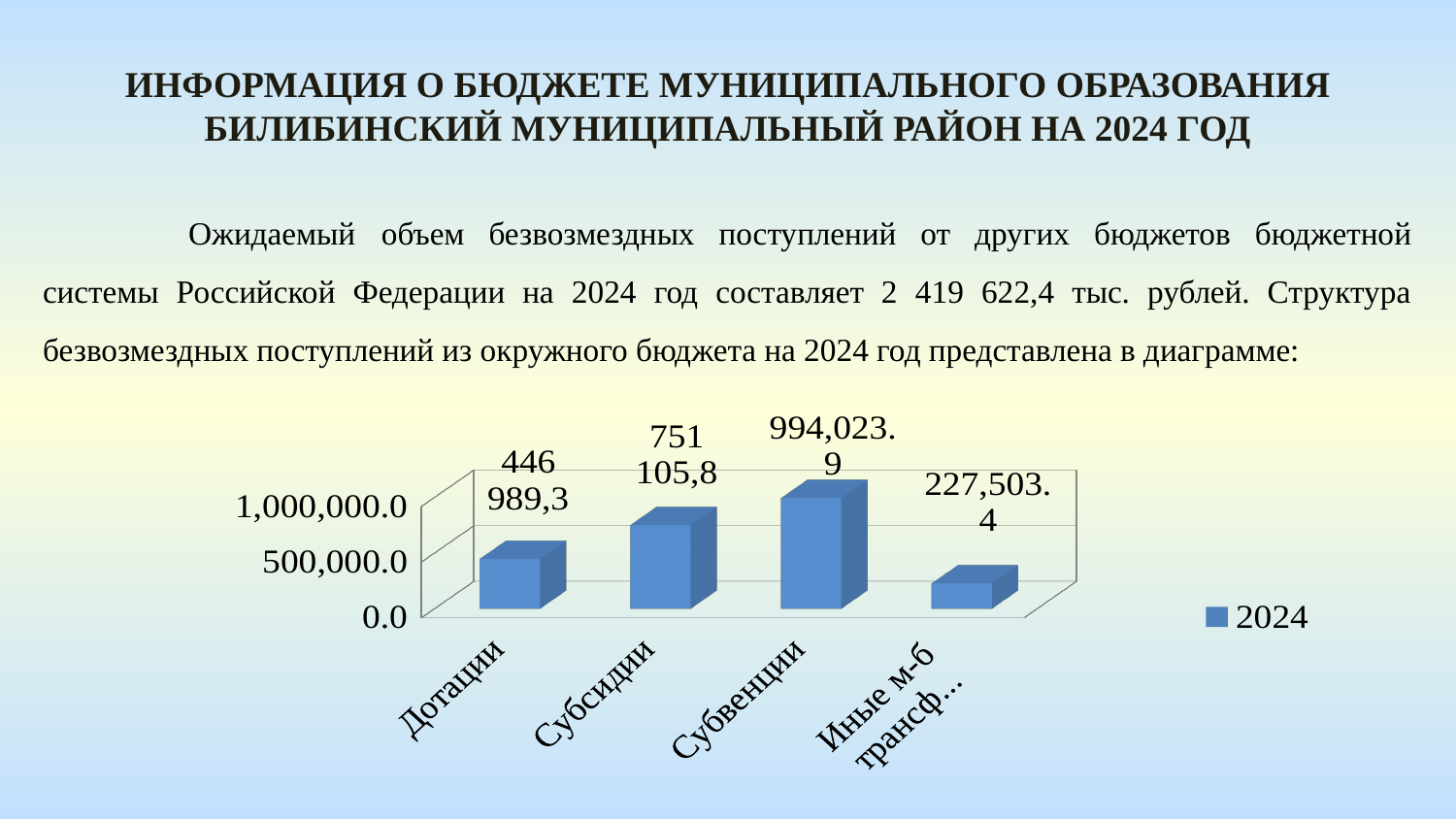
Which category has the highest value? Субвенции What type of chart is shown on the slide? bar chart What is the value for Дотации? 446 989,3 What is the value for the fourth category, Иные м-б трансф...? 227,503.4 What is the difference between the value for Субвенции and the value for Иные м-б трансф...? 766,520.5 What is the value for Субсидии? 751 105,8 Is the value for Дотации greater or less than 500,000.0? less How many categories are shown on the chart? 4 Which category has the lowest value? Иные м-б трансф... What is the value for Субвенции? 994,023.9 Which is larger, the value for Субсидии or the value for Дотации? Субсидии What series does the chart legend list? 2024